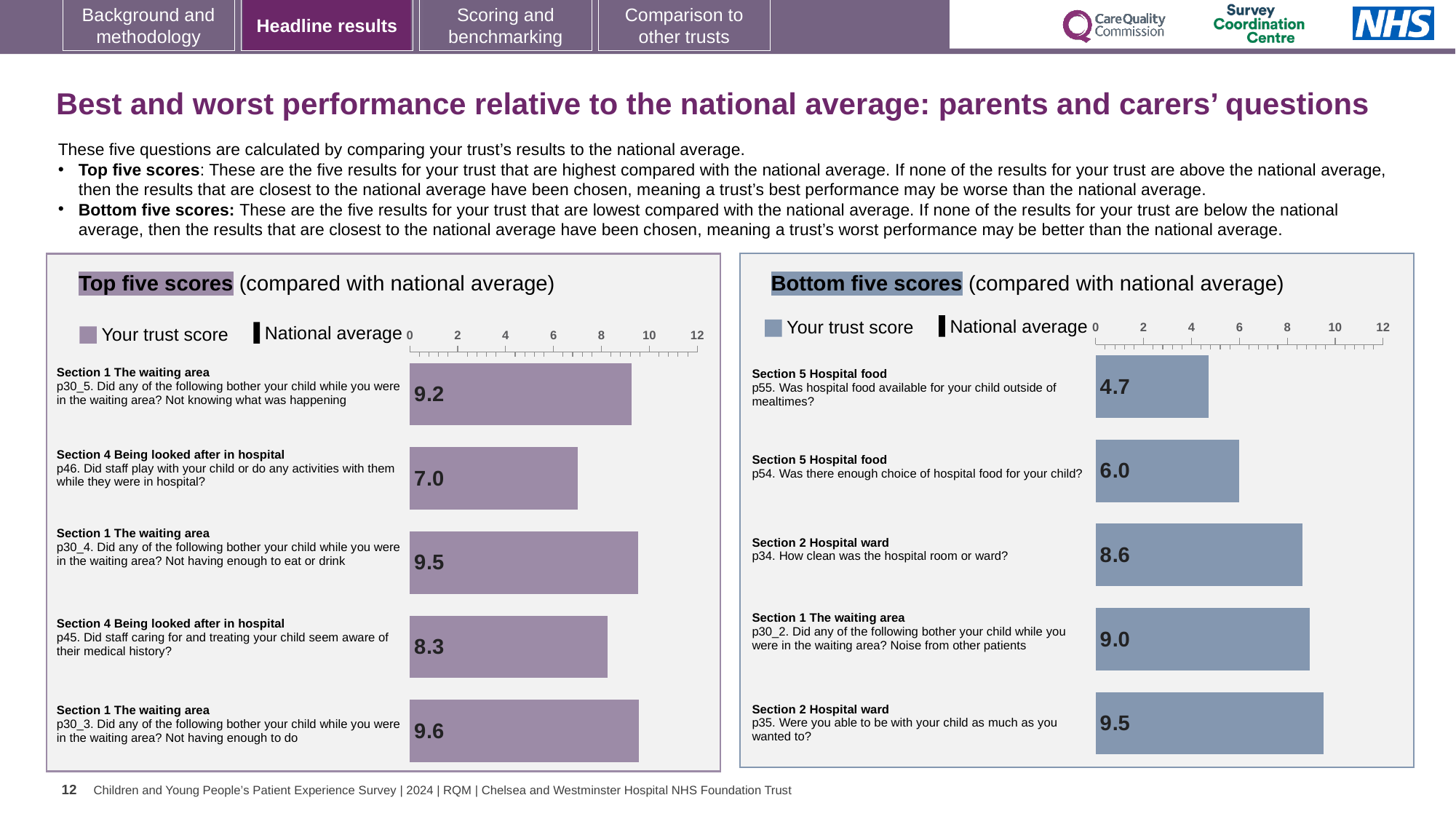
In the Bottom five scores chart, what is the trust score for p30_2 (Noise from other patients in the waiting area)? 9.0 In the Bottom five scores chart, what is the difference between the score for p35 (9.5) and the score for p55 (4.7)? 4.8 In the Top five scores chart, which question has the highest trust score? p30_3. Not having enough to do in the waiting area (9.6) In the Bottom five scores chart, which has the larger trust score: p34 (How clean was the hospital room or ward?) or p54 (Was there enough choice of hospital food for your child?)? p34 (8.6) In the Bottom five scores chart, which question has the lowest trust score? p55. Was hospital food available for your child outside of mealtimes? (4.7) In the Top five scores chart, which question has the lowest trust score? p46. Did staff play with your child or do any activities with them (7.0) How many series does the legend of the Bottom five scores chart list? 2 In the Bottom five scores chart, is the trust score for p55 (hospital food available outside of mealtimes) greater or less than 6? less In the Top five scores chart, what is the difference between the highest score (9.6) and the lowest score (7.0)? 2.6 In the Top five scores chart, what is the trust score for p46 (Did staff play with your child or do any activities with them while they were in hospital?)? 7.0 How many bars are shown in the Top five scores chart? 5 In the Bottom five scores chart, what is the trust score for p55 (Was hospital food available for your child outside of mealtimes?)? 4.7